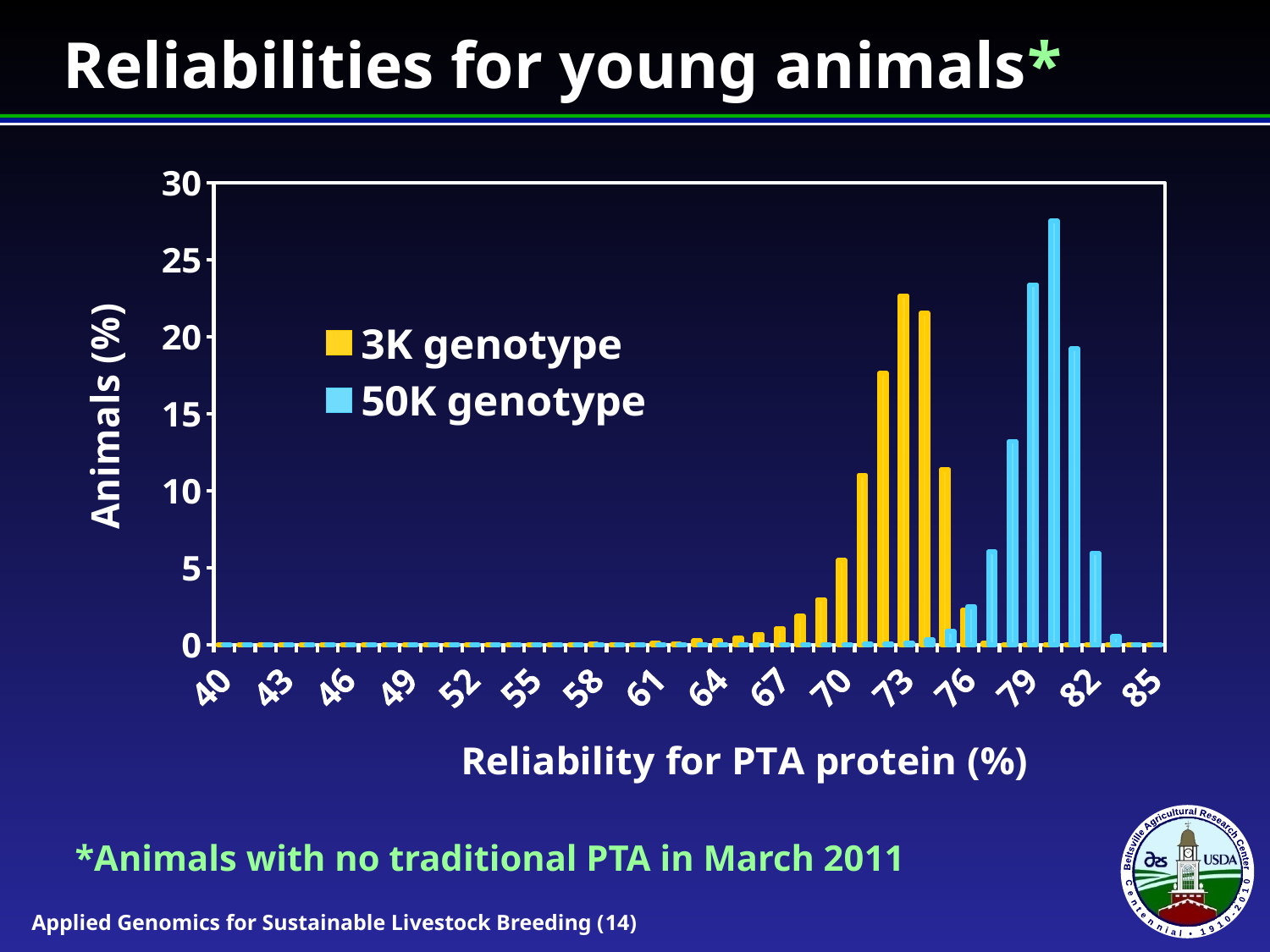
Is the 3K genotype value at reliability 70 greater or less than 10? less Is the 3K genotype value at reliability 73 greater or less than 20? greater Is the tallest 50K genotype bar greater or less than 25? greater How many series does the legend list? 2 How many tick labels are shown on the x axis? 16 Which series reaches the highest value on the chart? 50K genotype What kind of chart is shown on the slide? bar chart Which series has its peak at a higher reliability value, 3K genotype or 50K genotype? 50K genotype What is the title of the y axis? Animals (%)